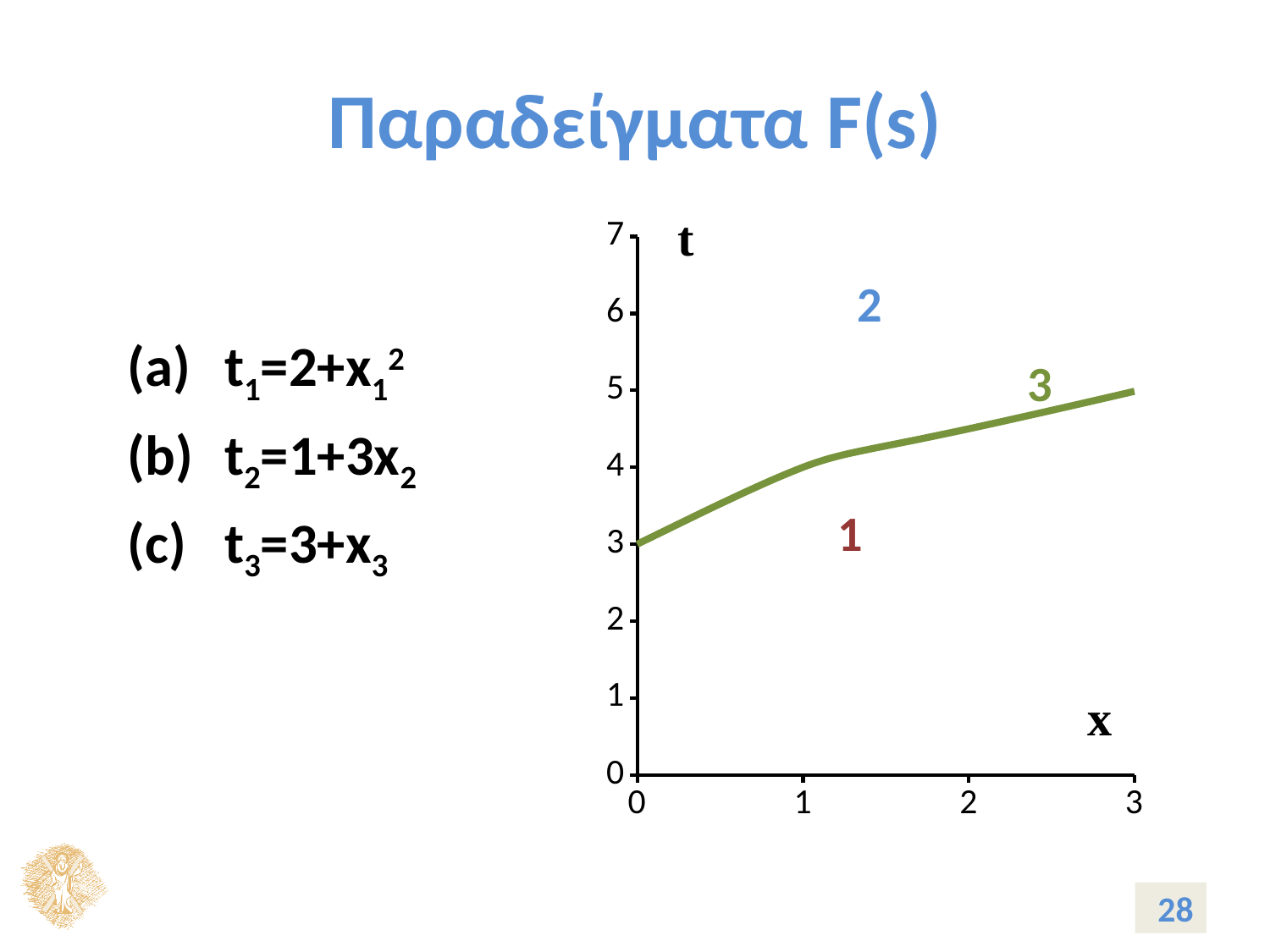
At which x value does the line reach its highest t value? 3 What is the highest tick value shown on the vertical axis? 7 How many tick values are labelled on the horizontal x axis? 4 Is the value of t at x = 2 greater or less than 4? greater Is the value of t at x = 0.5 greater or less than 4? less What is the label on the vertical axis of the chart? t Does the plotted line rise or fall as x increases from 0 to 3? rises Which has the larger t value on the line: x = 0 or x = 3? x = 3 Is the value of t at x = 2 greater or less than 5? less What is the value of t where the line meets the vertical axis at x = 0? 3 What kind of chart is shown on the slide? line chart